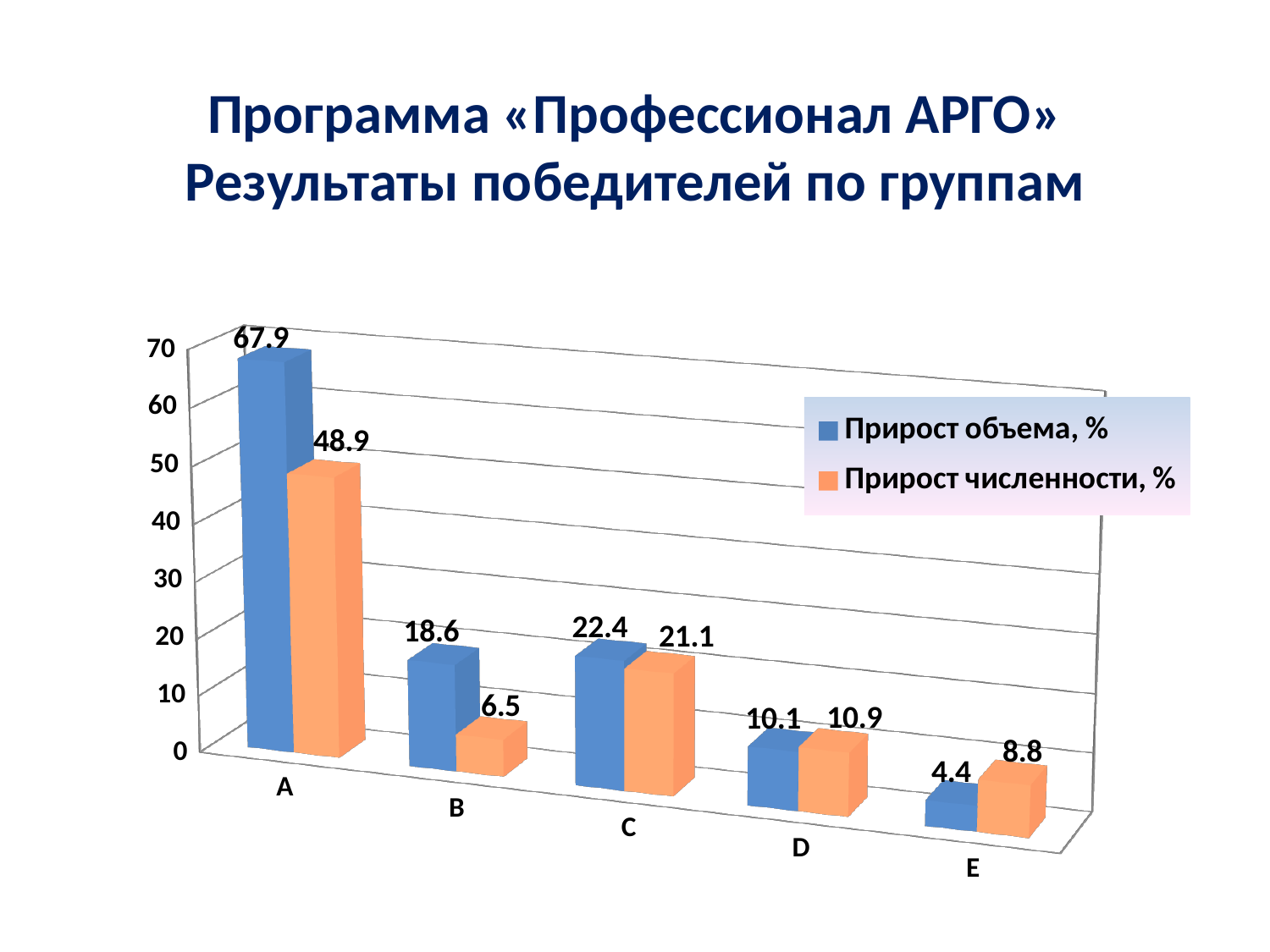
What is the difference between Прирост объема, % and Прирост численности, % for group A? 19 Which is larger for group D: Прирост объема, % or Прирост численности, %? Прирост численности, % What is the difference between Прирост объема, % for group C and group B? 3.8 Which group has the highest Прирост объема, %? A Which series is shown in orange? Прирост численности, % How many series does the legend list? 2 What is the value of Прирост численности, % for group B? 6.5 What kind of chart is shown on the slide? bar chart How many groups are shown on the x axis? 5 What is the value of Прирост численности, % for group E? 8.8 What is the value of Прирост объема, % for group A? 67.9 Which group has the lowest Прирост численности, %? B